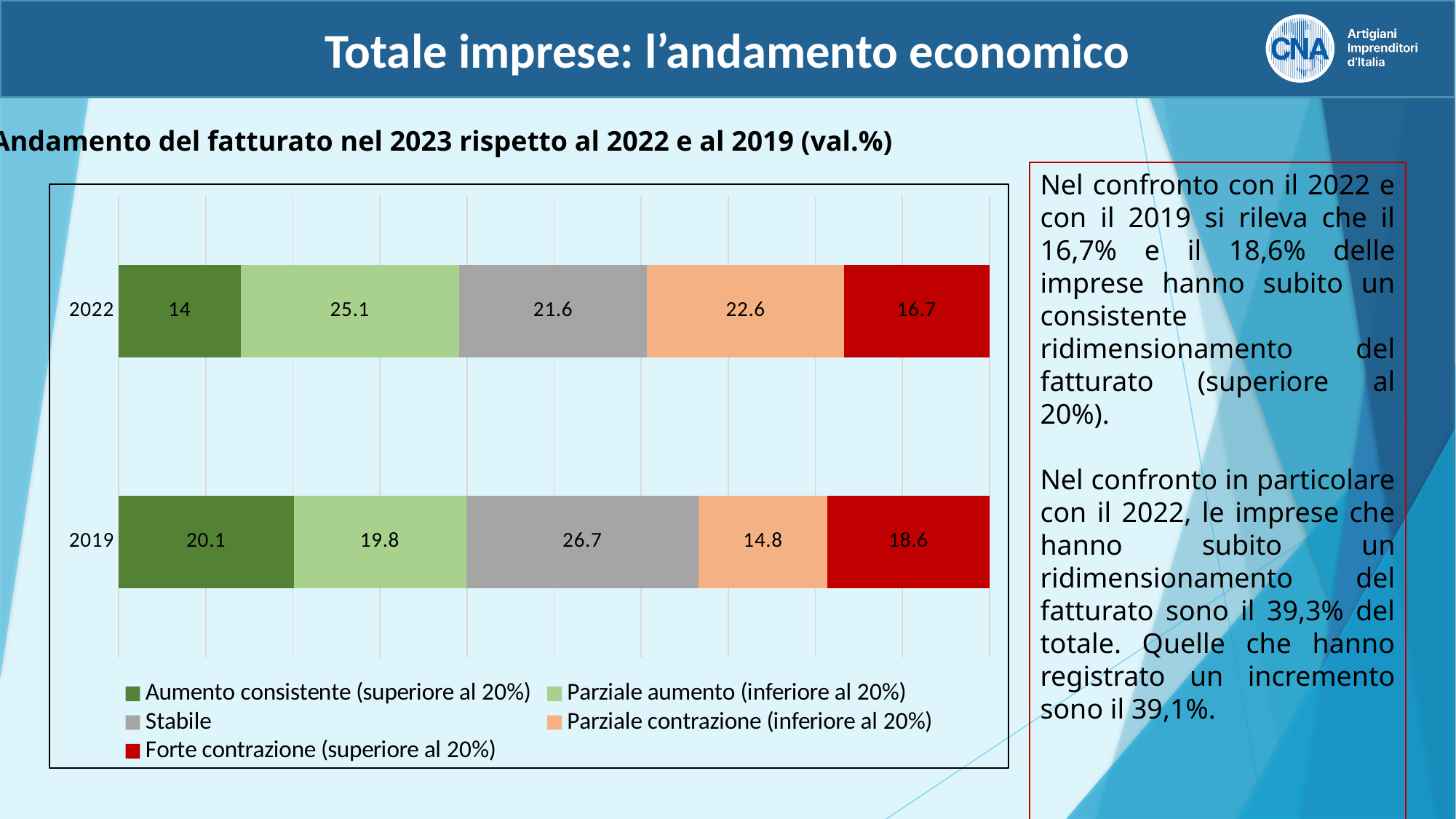
What is the value for 'Stabile' in the 2019 bar? 26.7 What is the difference between the 'Parziale contrazione (inferiore al 20%)' values for 2022 and 2019? 7.8 Which is larger: 'Aumento consistente (superiore al 20%)' for 2022 or for 2019? 2019 What is the total of the 2019 stacked bar? 100 What kind of chart is shown on the slide? Stacked bar chart Which segment is the smallest in the 2019 bar? Parziale contrazione (inferiore al 20%) What is the value for 'Forte contrazione (superiore al 20%)' in the 2022 bar? 16.7 What colour represents 'Stabile' in the chart? Grey Which segment is the largest in the 2022 bar? Parziale aumento (inferiore al 20%) How many categories (bars) are plotted in the chart? 2 How many series does the legend list? 5 What is the value for 'Aumento consistente (superiore al 20%)' in the 2019 bar? 20.1